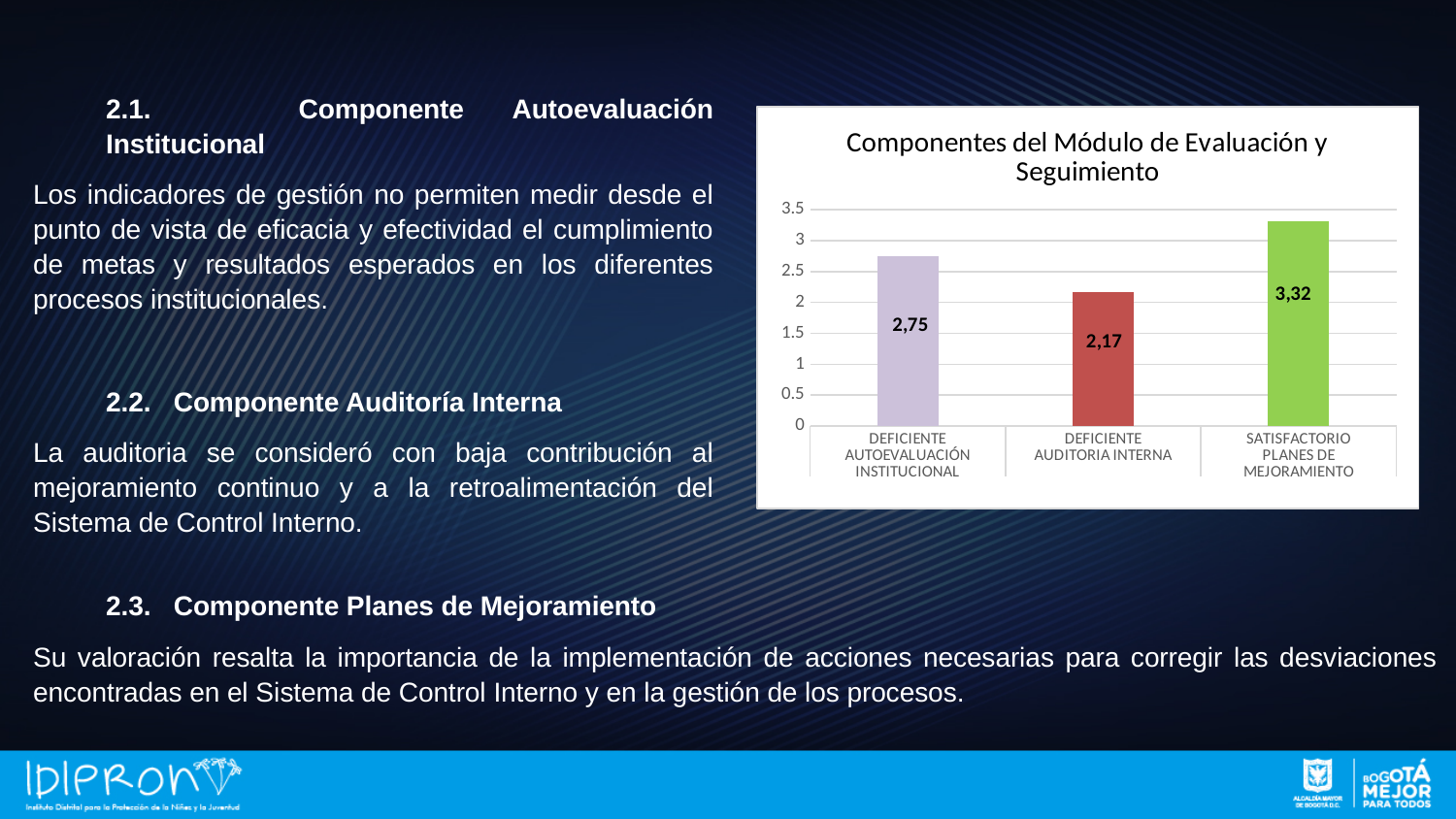
What is the title of the chart? Componentes del Módulo de Evaluación y Seguimiento What is the value for SATISFACTORIO PLANES DE MEJORAMIENTO? 3,32 Which category has the lowest value? DEFICIENTE AUDITORIA INTERNA What is the value for DEFICIENTE AUDITORIA INTERNA? 2,17 What is the difference between the values for DEFICIENTE AUTOEVALUACIÓN INSTITUCIONAL and DEFICIENTE AUDITORIA INTERNA? 0,58 What is the difference between the values for SATISFACTORIO PLANES DE MEJORAMIENTO and DEFICIENTE AUDITORIA INTERNA? 1,15 Which category has the highest value? SATISFACTORIO PLANES DE MEJORAMIENTO How many categories are shown in the chart? 3 What kind of chart is shown on the slide? bar chart Is the value for SATISFACTORIO PLANES DE MEJORAMIENTO greater or less than 3? greater Which is larger, the value for DEFICIENTE AUTOEVALUACIÓN INSTITUCIONAL or the value for DEFICIENTE AUDITORIA INTERNA? DEFICIENTE AUTOEVALUACIÓN INSTITUCIONAL What is the value for DEFICIENTE AUTOEVALUACIÓN INSTITUCIONAL? 2,75